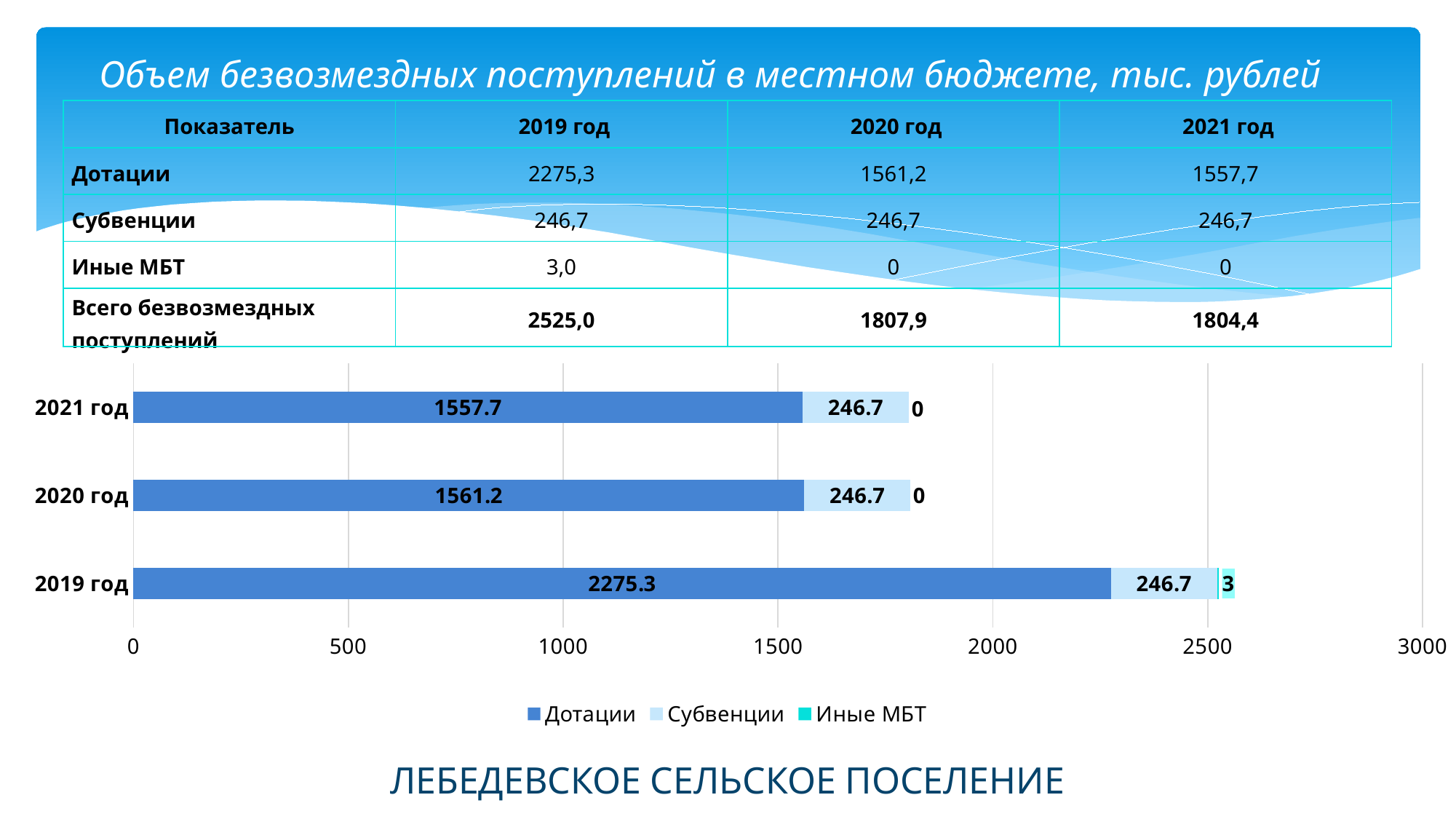
Which year has the highest value of Дотации in the chart? 2019 год What is the value of Дотации for 2021 год in the chart? 1557.7 Is the Дотации value for 2020 год greater or less than 2000? less What is the value of Иные МБТ for 2019 год in the chart? 3 What is the total of the stacked bar for 2019 год? 2525 How many year categories are plotted in the chart? 3 How many series does the chart legend list? 3 Which series is shown in the darkest blue colour in the chart? Дотации What type of chart is shown on the slide? Stacked bar chart What is the difference between the Дотации values for 2019 год and 2020 год? 714.1 What is the value of Субвенции for 2020 год in the chart? 246.7 What is the value of Дотации for 2019 год in the chart? 2275.3